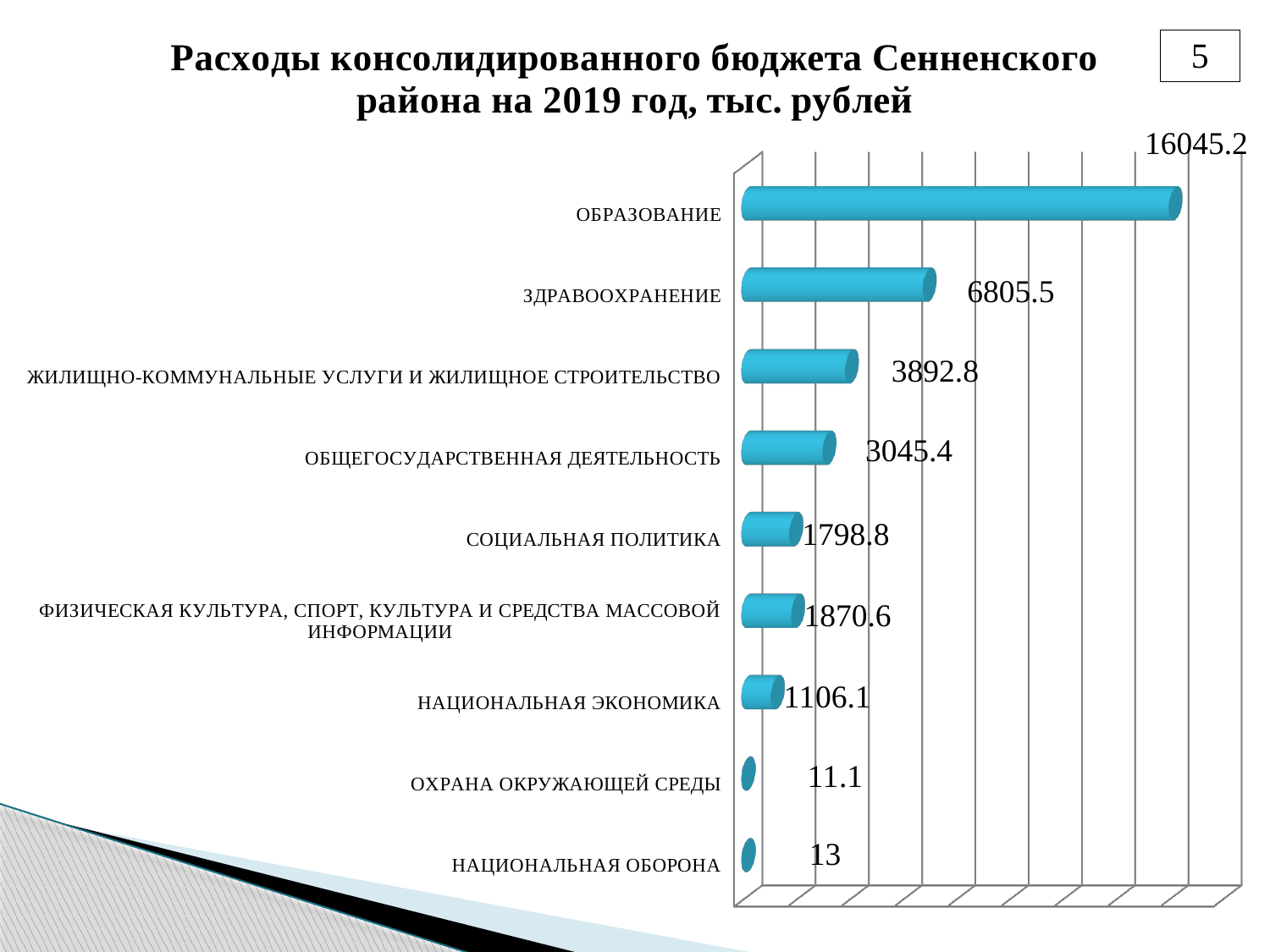
What is the difference between the values for ЖИЛИЩНО-КОММУНАЛЬНЫЕ УСЛУГИ И ЖИЛИЩНОЕ СТРОИТЕЛЬСТВО and ОБЩЕГОСУДАРСТВЕННАЯ ДЕЯТЕЛЬНОСТЬ? 847.4 What is the value for ОБРАЗОВАНИЕ? 16045.2 What is the value for ОХРАНА ОКРУЖАЮЩЕЙ СРЕДЫ? 11.1 What is the difference between the values for ОБРАЗОВАНИЕ and ЗДРАВООХРАНЕНИЕ? 9239.7 What kind of chart is shown on the slide? Bar chart What is the value for ЗДРАВООХРАНЕНИЕ? 6805.5 How many categories are shown in the chart? 9 Which is larger, the value for СОЦИАЛЬНАЯ ПОЛИТИКА or the value for ФИЗИЧЕСКАЯ КУЛЬТУРА, СПОРТ, КУЛЬТУРА И СРЕДСТВА МАССОВОЙ ИНФОРМАЦИИ? ФИЗИЧЕСКАЯ КУЛЬТУРА, СПОРТ, КУЛЬТУРА И СРЕДСТВА МАССОВОЙ ИНФОРМАЦИИ Which is larger, the value for НАЦИОНАЛЬНАЯ ОБОРОНА or the value for ОХРАНА ОКРУЖАЮЩЕЙ СРЕДЫ? НАЦИОНАЛЬНАЯ ОБОРОНА Which category has the highest value? ОБРАЗОВАНИЕ What is the value for НАЦИОНАЛЬНАЯ ЭКОНОМИКА? 1106.1 Which category has the lowest value? ОХРАНА ОКРУЖАЮЩЕЙ СРЕДЫ